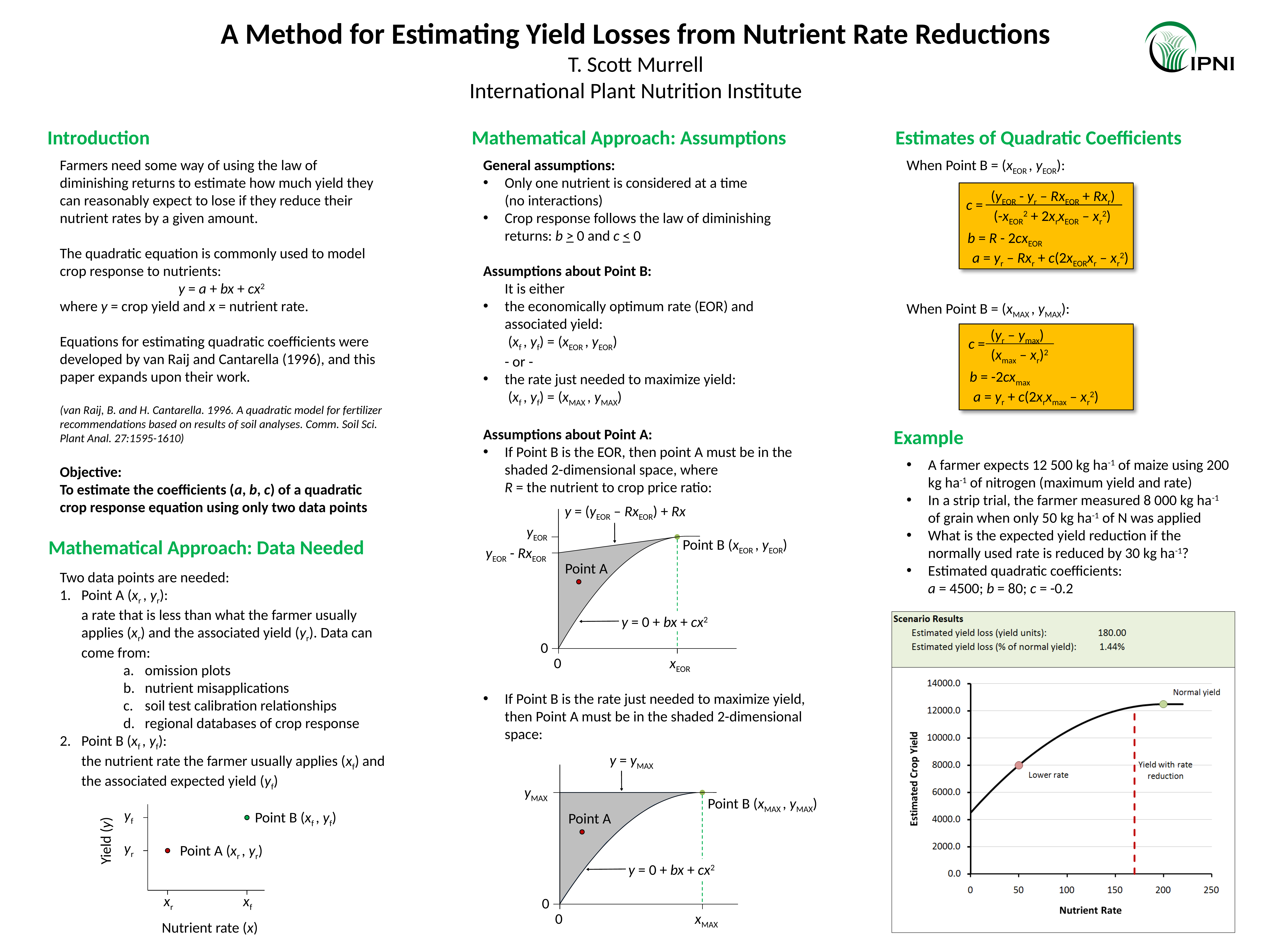
In the Scenario Results chart, is the estimated crop yield at the 'Normal yield' point greater or less than 10000.0? greater What is the y-axis label of the Scenario Results chart? Estimated Crop Yield In the Scenario Results chart, does the estimated crop yield rise or fall as the nutrient rate increases from 0 to 200? rises In the Scenario Results chart, what is the estimated crop yield at the point labelled 'Lower rate'? 8000.0 In the Scenario Results chart, at what nutrient rate is the point labelled 'Normal yield' plotted? 200 What is the x-axis label of the Scenario Results chart? Nutrient Rate What kind of chart is the Scenario Results chart at the bottom right of the slide? line chart In the Scenario Results chart, is the red dashed line marking 'Yield with rate reduction' at a nutrient rate greater or less than 150? greater In the Scenario Results chart, what is the estimated yield loss as a percent of normal yield? 1.44% In the Scenario Results chart, is the estimated crop yield at the 'Lower rate' point greater or less than 6000.0? greater In the Scenario Results chart, what is the estimated yield loss in yield units? 180.00 In the Scenario Results chart, how many labelled data points are marked on the curve? 2